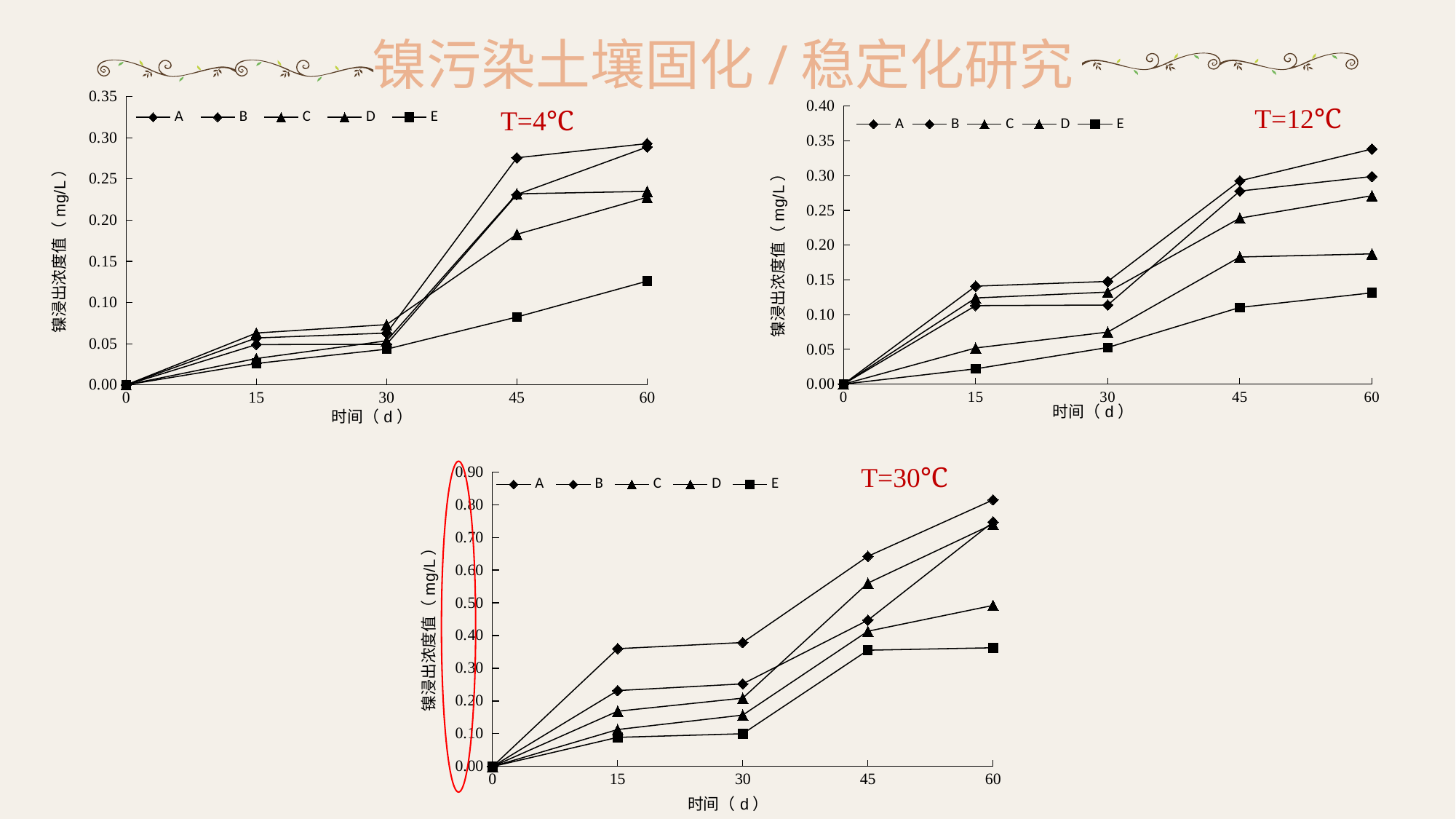
In the T=12℃ chart, is the value for series E at 15 d greater or less than 0.05? less In the T=30℃ chart, which series has the lowest value at 60 d? E In the T=12℃ chart, which series has the lowest value at 60 d? E Is the value for series E at 60 d larger in the T=30℃ chart or in the T=4℃ chart? T=30℃ What is the x-axis label of the T=12℃ chart? 时间（d） In the T=4℃ chart, which series has the lowest value at 60 d? E How many time points are plotted along the x axis of the T=30℃ chart? 5 In the T=4℃ chart, is the value for series E at 60 d greater or less than 0.15? less What kind of chart is the T=4℃ chart? line chart How many series does the legend of the T=12℃ chart list? 5 In the T=30℃ chart, is the value for series E at 60 d greater or less than 0.40? less In the T=4℃ chart, does series E rise or fall from 0 d to 60 d? rise